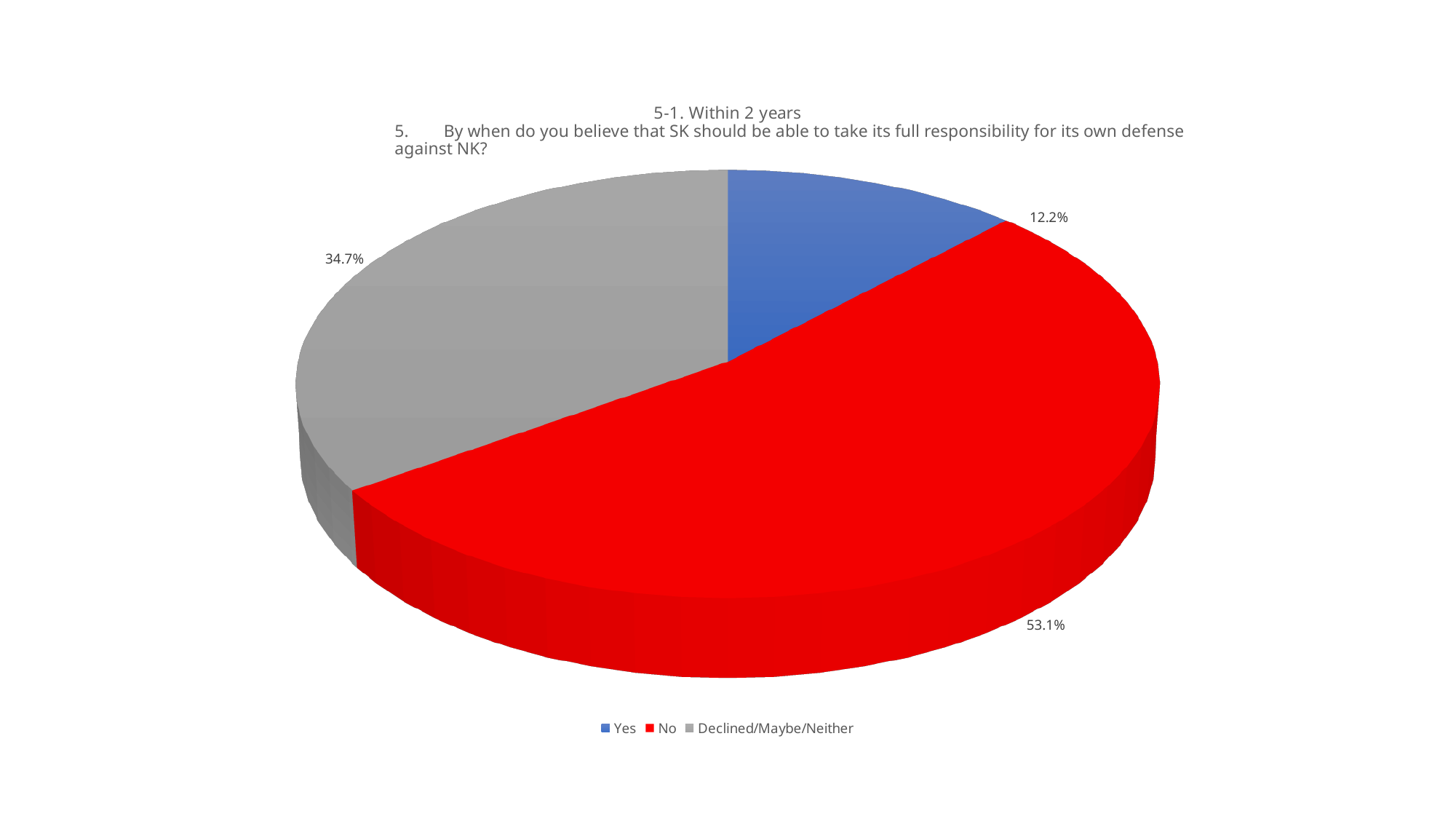
What percentage of respondents answered "No"? 53.1% How many slices does the pie chart have? 3 What percentage of respondents answered "Declined/Maybe/Neither"? 34.7% Which response has the largest share of the pie? No What colour is the "No" slice? red What is the difference in percentage points between the "No" share and the "Yes" share? 40.9 What percentage of respondents answered "Yes"? 12.2% Which is larger, the share for "No" or the share for "Declined/Maybe/Neither"? No How many entries does the legend list? 3 What kind of chart is shown on the slide? pie chart Which response has the smallest share of the pie? Yes What is the difference in percentage points between the "Declined/Maybe/Neither" share and the "Yes" share? 22.5